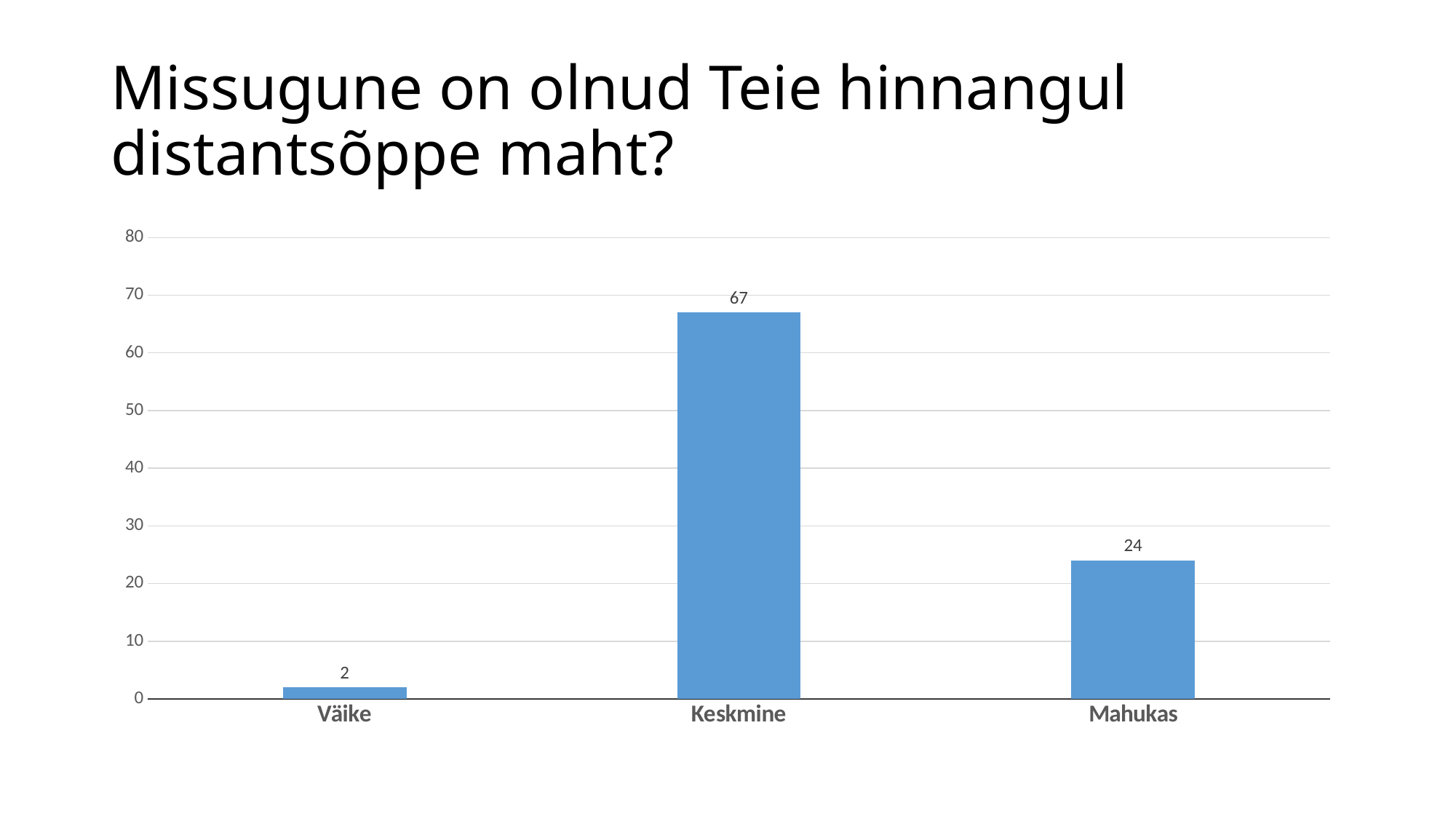
Is the value for Keskmine greater or less than 60? greater Which category has the lowest value? Väike What is the title of the slide? Missugune on olnud Teie hinnangul distantsõppe maht? Which category has the highest value? Keskmine What is the difference between the values for Mahukas and Väike? 22 What kind of chart is shown on the slide? bar chart What is the value for Keskmine? 67 What is the value for Väike? 2 What is the value for Mahukas? 24 Which is larger, the value for Mahukas or the value for Väike? Mahukas How many categories are shown on the x axis? 3 What is the difference between the values for Keskmine and Mahukas? 43